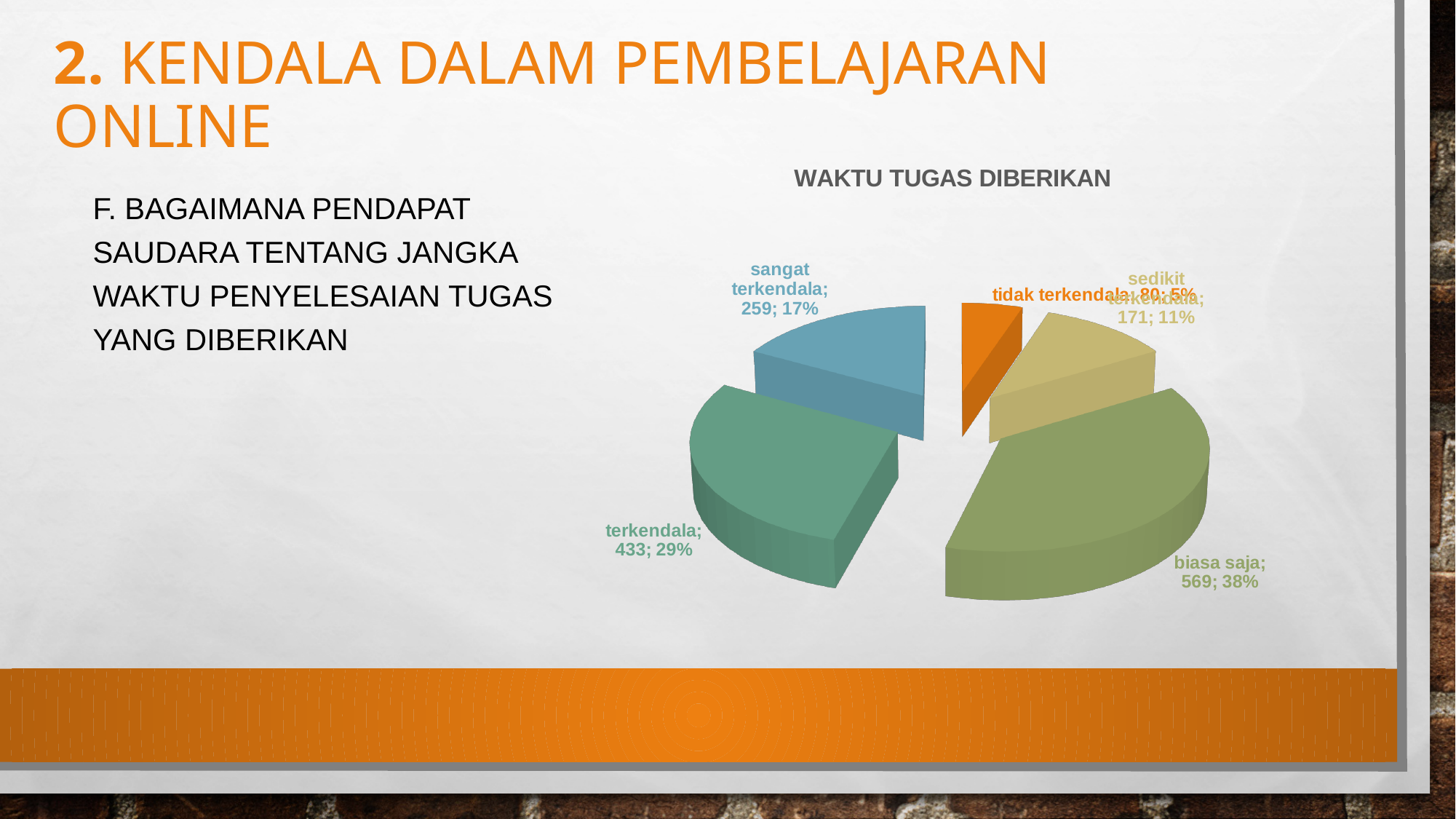
Which is larger, the value for 'sangat terkendala' or the value for 'sedikit terkendala'? sangat terkendala What is the value for 'sangat terkendala'? 259 How many slices does the pie chart have? 5 What is the value for 'biasa saja'? 569 What is the difference between the values for 'biasa saja' and 'terkendala'? 136 What is the title of the chart? WAKTU TUGAS DIBERIKAN Which category has the smallest slice? tidak terkendala What percentage share does 'tidak terkendala' have? 5% Which category has the largest slice? biasa saja What is the value for 'terkendala'? 433 What percentage share does 'sedikit terkendala' have? 11% What type of chart is shown on the slide? pie chart